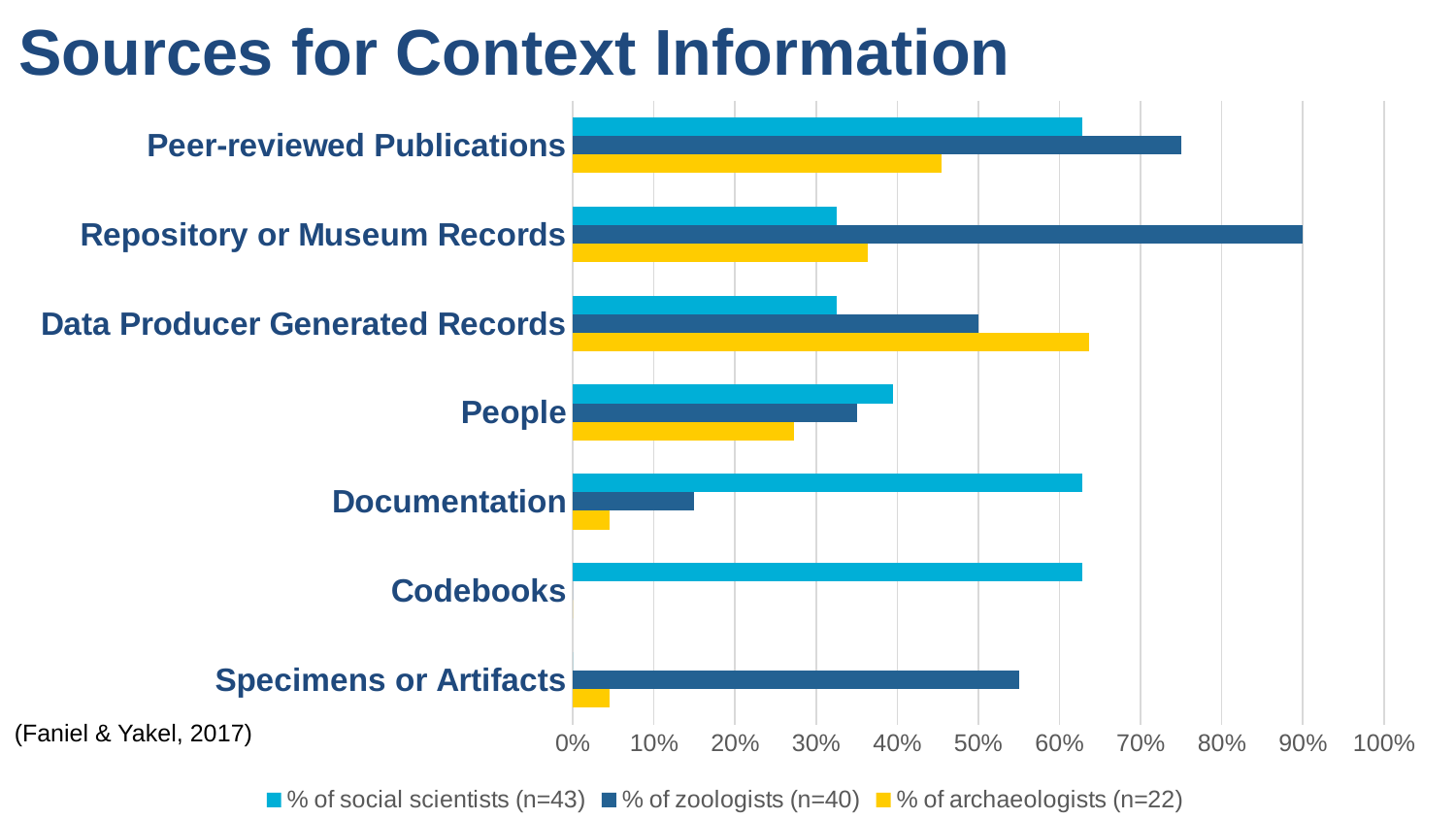
Is the value for archaeologists for People greater or less than 30%? less What is the value for zoologists for Data Producer Generated Records? 50% What is the value for zoologists for Repository or Museum Records? 90% How many source categories are listed on the chart? 7 For which category is the value for zoologists highest? Repository or Museum Records Which series does the yellow bar represent? % of archaeologists (n=22) For which category is the value for archaeologists highest? Data Producer Generated Records For Documentation, which is larger: the value for social scientists or the value for zoologists? social scientists How many series does the legend list? 3 What is the title of the chart? Sources for Context Information Is the value for social scientists for Peer-reviewed Publications greater or less than 60%? greater What kind of chart is shown on the slide? bar chart